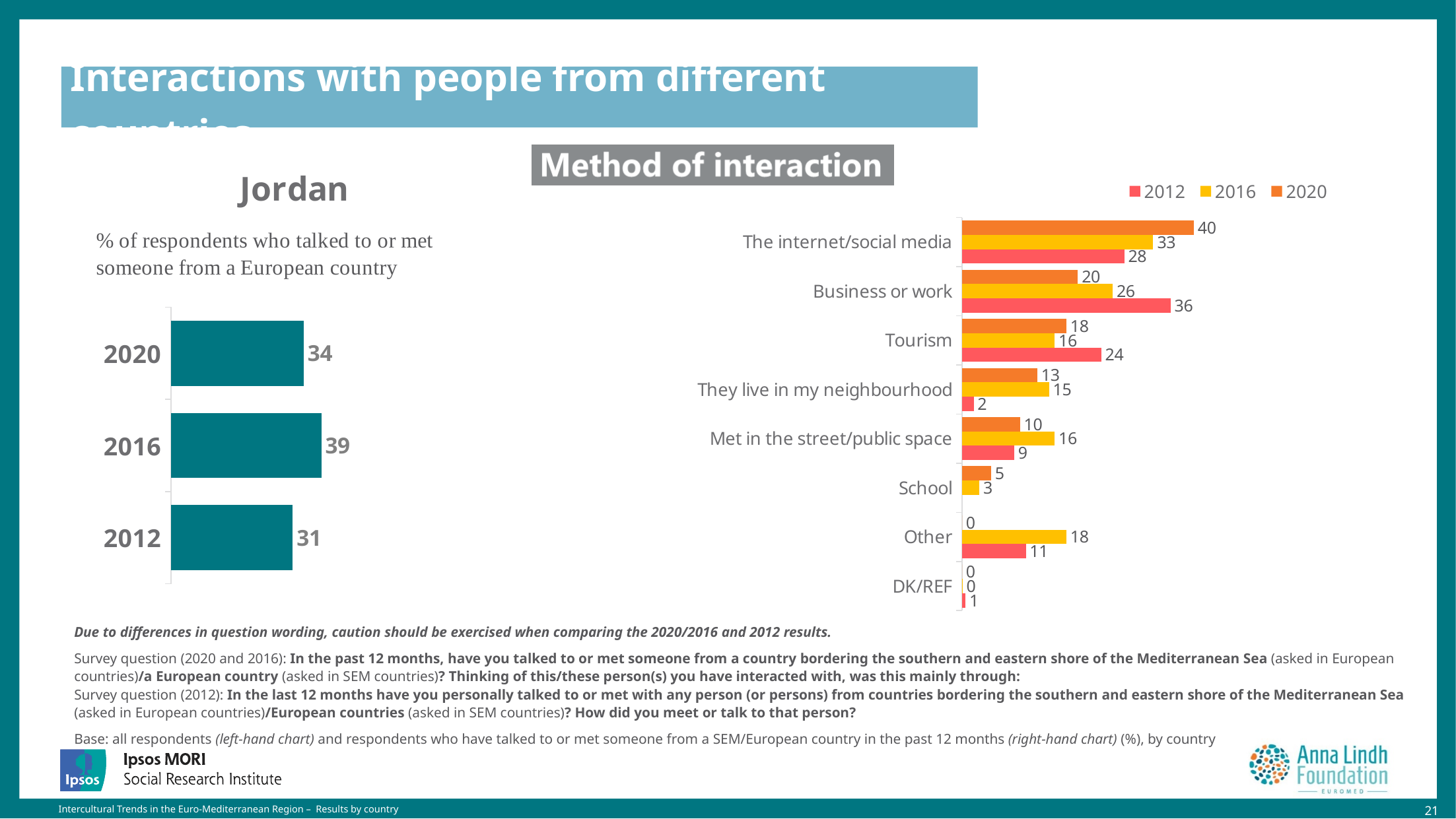
In the Method of interaction chart, how many series does the legend list? 3 In the Method of interaction chart, what is the 2020 value for The internet/social media? 40 In the Jordan chart, what percentage of respondents talked to or met someone from a European country in 2016? 39 In the Jordan chart, which year has the lowest value? 2012 In the Method of interaction chart, which is larger for They live in my neighbourhood: the 2016 value or the 2012 value? 2016 In the Jordan chart, what is the difference between the 2016 and 2020 values? 5 What type of chart is the Method of interaction chart? Bar chart In the Method of interaction chart, which method has the highest 2020 value? The internet/social media In the Jordan chart, how many years are shown? 3 In the Method of interaction chart, what is the 2012 value for Business or work? 36 In the Method of interaction chart, how many methods of interaction are listed? 8 In the Method of interaction chart, what is the difference between the 2012 and 2020 values for Tourism? 6